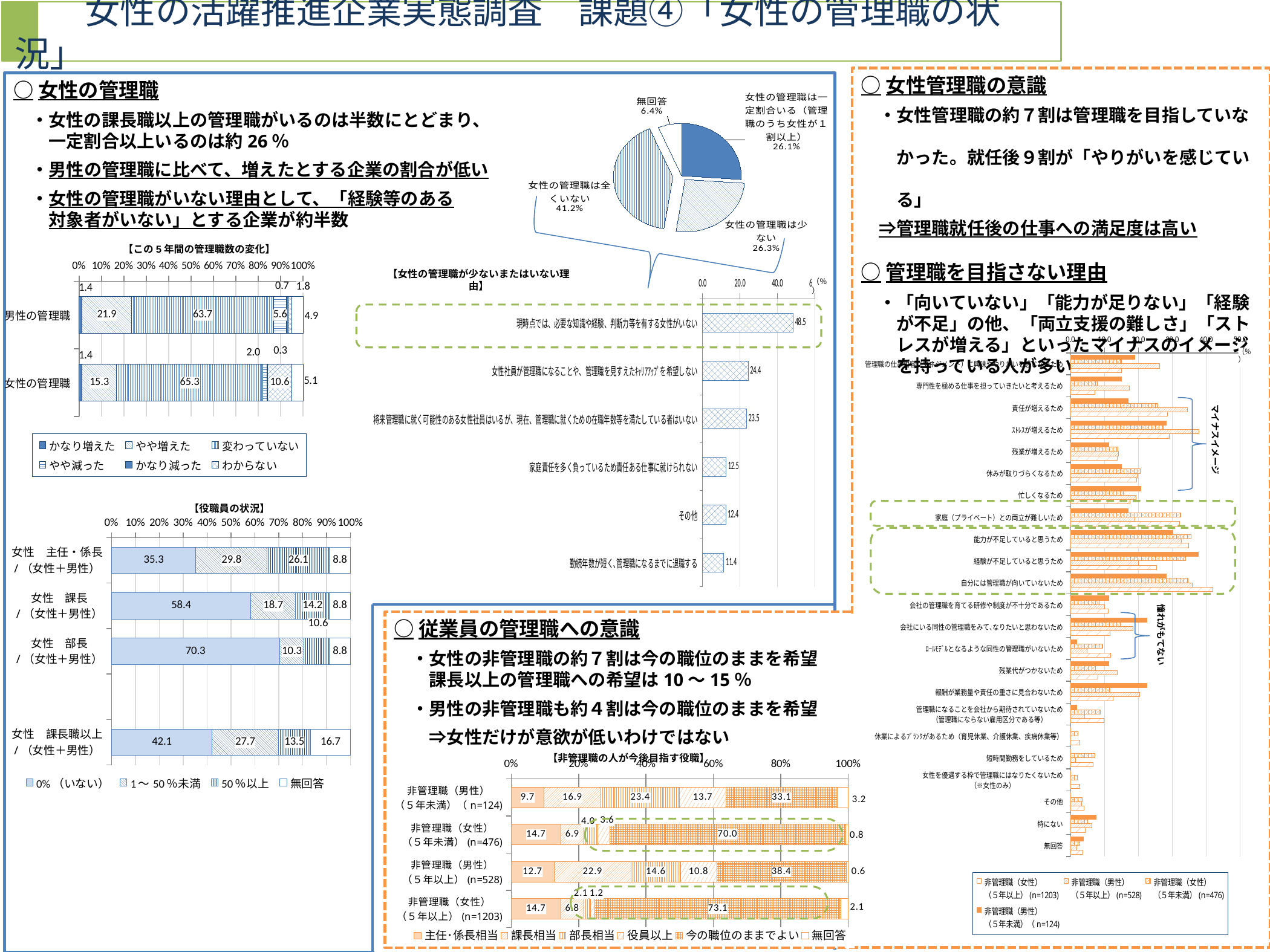
In the chart 【非管理職の人が今後目指す役職】, which is larger: the 「今の職位のままでよい」 value for 非管理職（男性）（5年未満） or for 非管理職（男性）（5年以上）? 非管理職（男性）（5年以上） In the chart 【この5年間の管理職数の変化】, what is the value of 「変わっていない」 for 女性の管理職? 65.3 In the chart 【女性の管理職が少ないまたはいない理由】, what is the value for 「現時点では、必要な知識や経験、判断力等を有する女性がいない」? 48.5 In the pie chart at the top centre of the slide, what share is labelled 「女性の管理職は全くいない」? 41.2% In the chart 【役職員の状況】, what is the value of 「0%（いない）」 for 女性 部長/（女性＋男性）? 70.3 In the chart 【女性の管理職が少ないまたはいない理由】, how many reason categories are plotted? 6 In the pie chart at the top centre of the slide, which slice is the largest? 女性の管理職は全くいない In the chart 【この5年間の管理職数の変化】, what is the value of 「やや増えた」 for 男性の管理職? 21.9 In the chart 【非管理職の人が今後目指す役職】, what is the value of 「今の職位のままでよい」 for 非管理職（女性）（5年以上）(n=1203)? 73.1 In the pie chart at the top centre of the slide, what share is labelled 「無回答」? 6.4% In the chart 【この5年間の管理職数の変化】, how many series does the legend list? 6 In the chart 【役職員の状況】, what is the difference between the 「0%（いない）」 values for 女性 課長 and 女性 主任・係長? 23.1